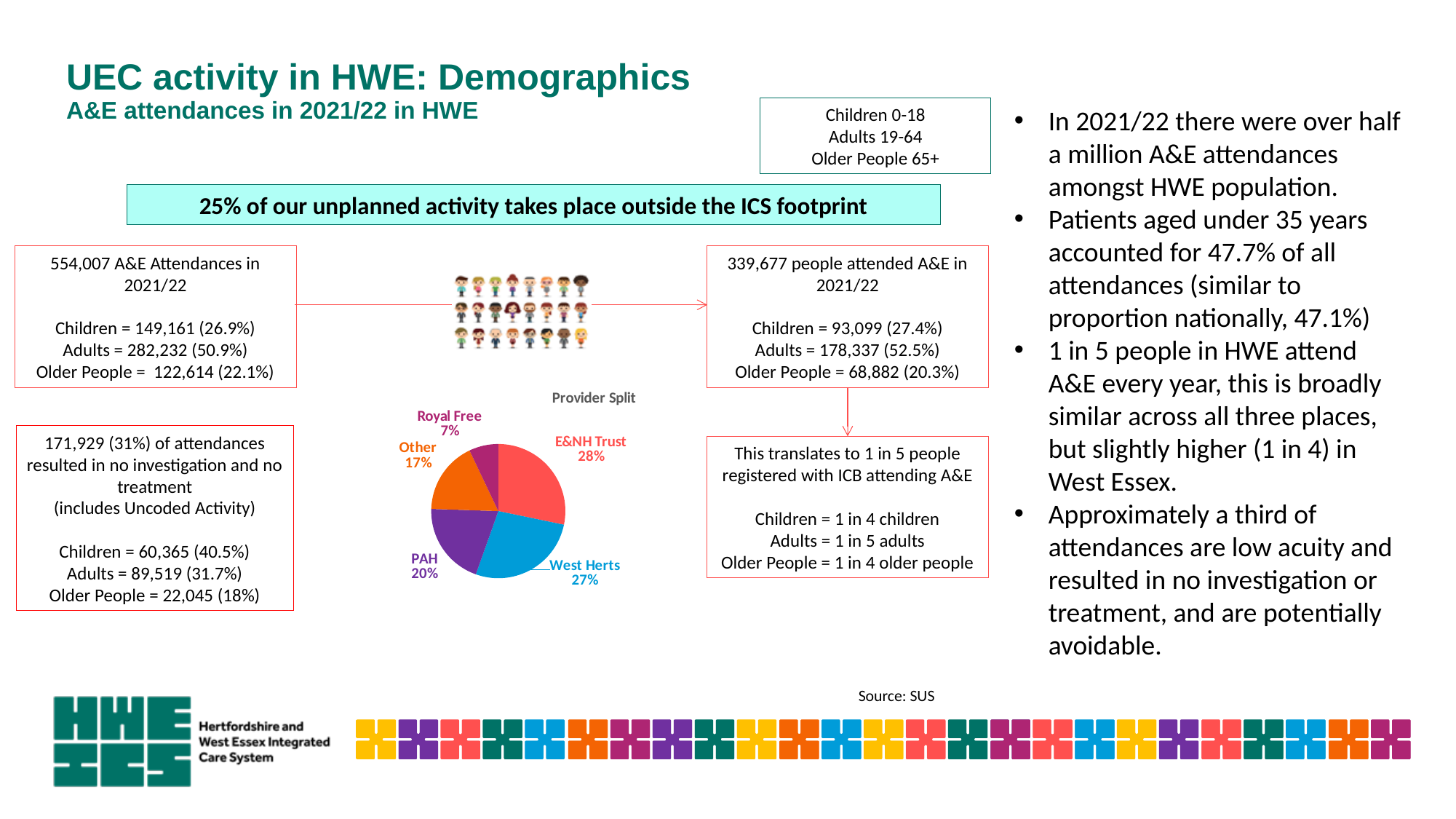
In the Provider Split chart, what is the difference in percentage points between PAH and Royal Free? 13 Which provider has the smallest slice in the Provider Split chart? Royal Free What type of chart is the "Provider Split" chart? Pie chart Which provider has the largest slice in the Provider Split chart? E&NH Trust What share of the Provider Split pie does West Herts account for? 27% What is the title of the pie chart? Provider Split What is the value shown for Royal Free in the Provider Split chart? 7% In the Provider Split chart, which is larger: the share for PAH or the share for Other? PAH How many slices does the Provider Split pie chart have? 5 What share of the Provider Split pie does E&NH Trust account for? 28% What is the value shown for PAH in the Provider Split chart? 20% What is the value shown for Other in the Provider Split chart? 17%